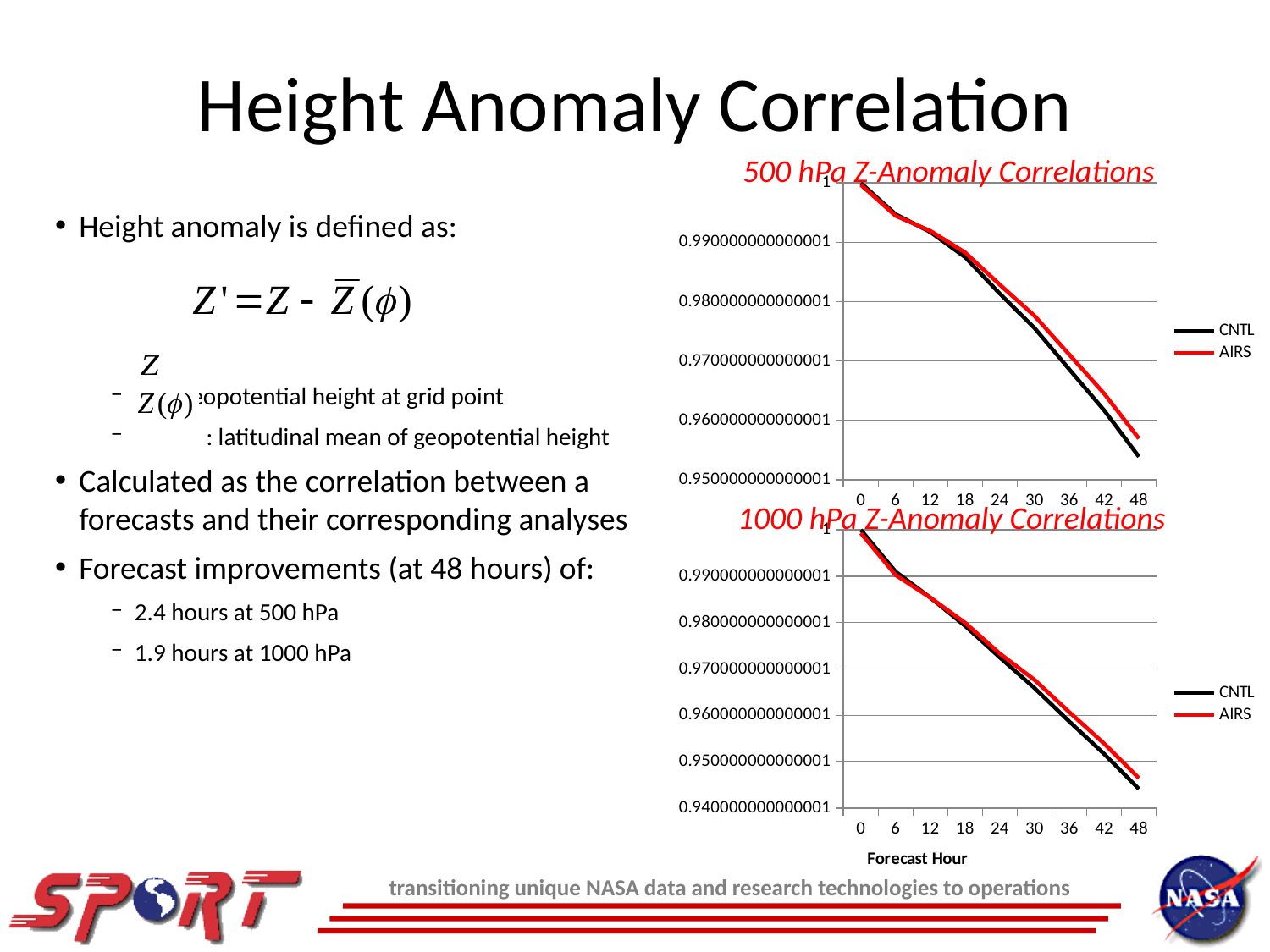
How many series does the legend of the 1000 hPa Z-Anomaly Correlations chart list? 2 What is the x-axis title of the 1000 hPa Z-Anomaly Correlations chart? Forecast Hour In the 500 hPa Z-Anomaly Correlations chart, what colour is the AIRS line? red What kind of chart is the 500 hPa Z-Anomaly Correlations chart? line chart In the 500 hPa Z-Anomaly Correlations chart, is the AIRS value at forecast hour 24 greater or less than 0.97? greater In the 500 hPa Z-Anomaly Correlations chart, which series has the higher value at forecast hour 48, CNTL or AIRS? AIRS In the 1000 hPa Z-Anomaly Correlations chart, which series has the higher value at forecast hour 48, CNTL or AIRS? AIRS In the 500 hPa Z-Anomaly Correlations chart, how many forecast hour points are marked along the x axis? 9 In the 1000 hPa Z-Anomaly Correlations chart, do the values rise or fall as the forecast hour increases? fall In the 500 hPa Z-Anomaly Correlations chart, is the CNTL value at forecast hour 48 greater or less than 0.96? less In the 1000 hPa Z-Anomaly Correlations chart, is the CNTL value at forecast hour 48 greater or less than 0.95? less